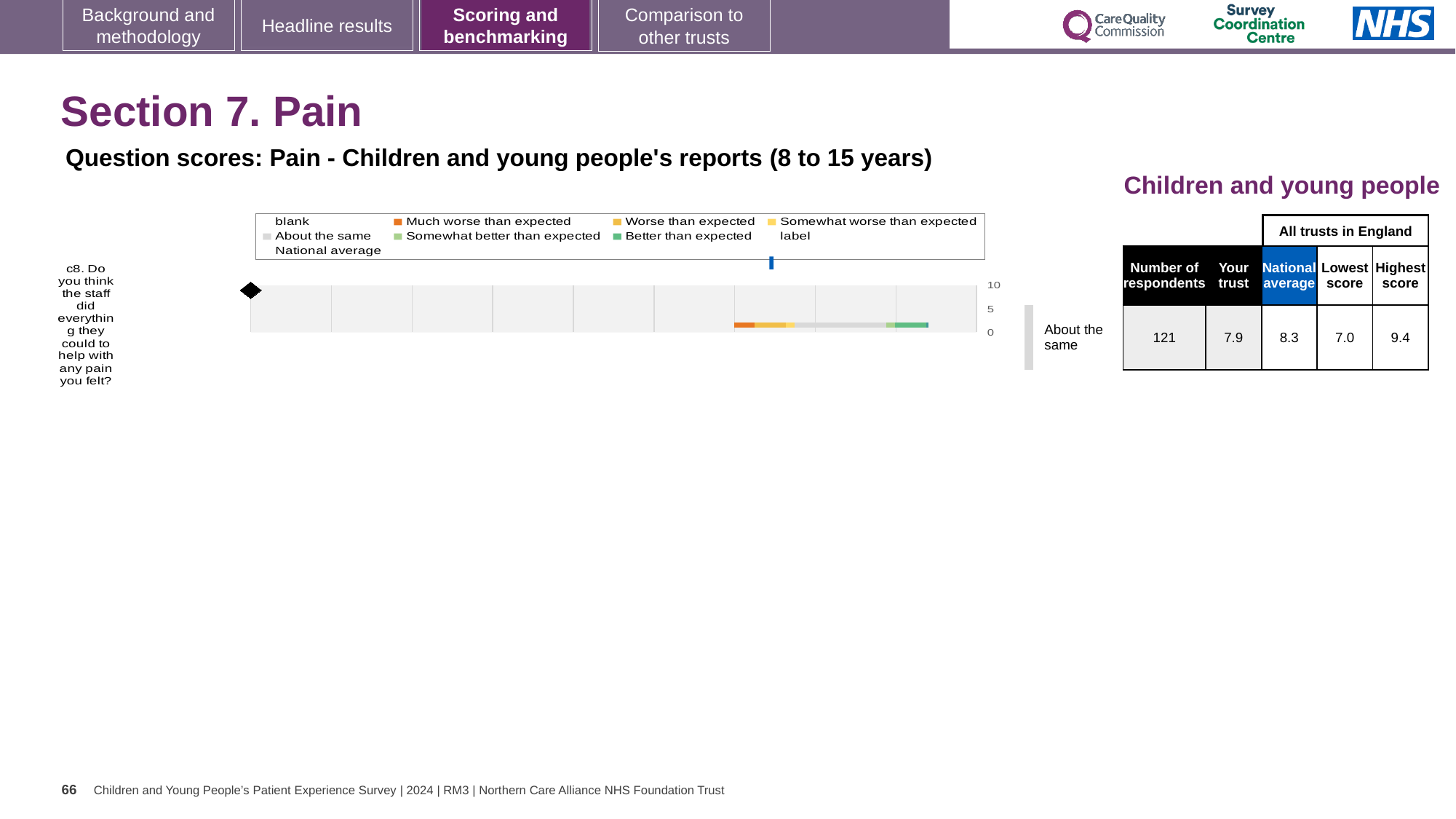
According to the table, how many respondents answered question c8? 121 What is the difference between the national average and the trust's score for question c8? 0.4 How many survey questions are plotted on the chart? 1 What kind of chart is used to show the question score for c8? bar chart According to the table, what is the lowest score among all trusts in England for question c8? 7.0 Which is larger for question c8: the trust's score or the national average? National average Which question is plotted on the chart? c8. Do you think the staff did everything they could to help with any pain you felt? What is the highest value shown on the chart's score axis? 10 According to the table, what is the highest score among all trusts in England for question c8? 9.4 According to the table, what is the national average score for question c8? 8.3 According to the table, what is the trust's score for question c8? 7.9 How is the trust's score for question c8 rated relative to what was expected? About the same